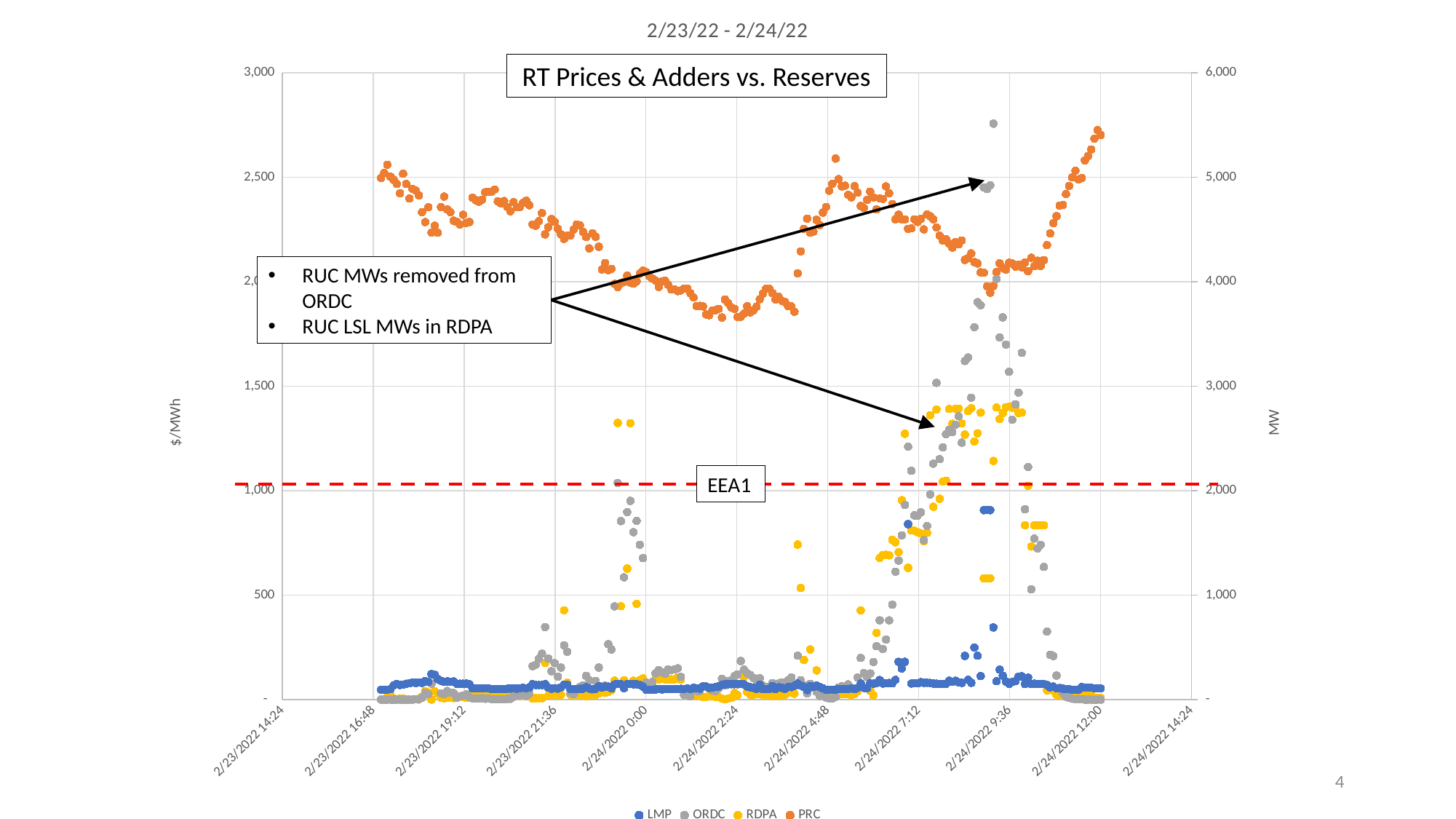
What does the red dashed horizontal line on the chart represent? EEA1 How many series does the legend list? 4 Which series reaches a higher peak on the left axis, ORDC or LMP? ORDC Is the highest LMP value greater or less than 500 on the left axis? greater Is the PRC value at 2/24/2022 2:24 greater or less than 4,000 MW? less What is the title of the chart? 2/23/22 - 2/24/22 Is the highest ORDC value greater or less than 2,500 on the left axis? greater What kind of chart is shown on the slide? scatter chart Does the PRC series rise or fall between 2/23/2022 16:48 and 2/24/2022 2:24? fall